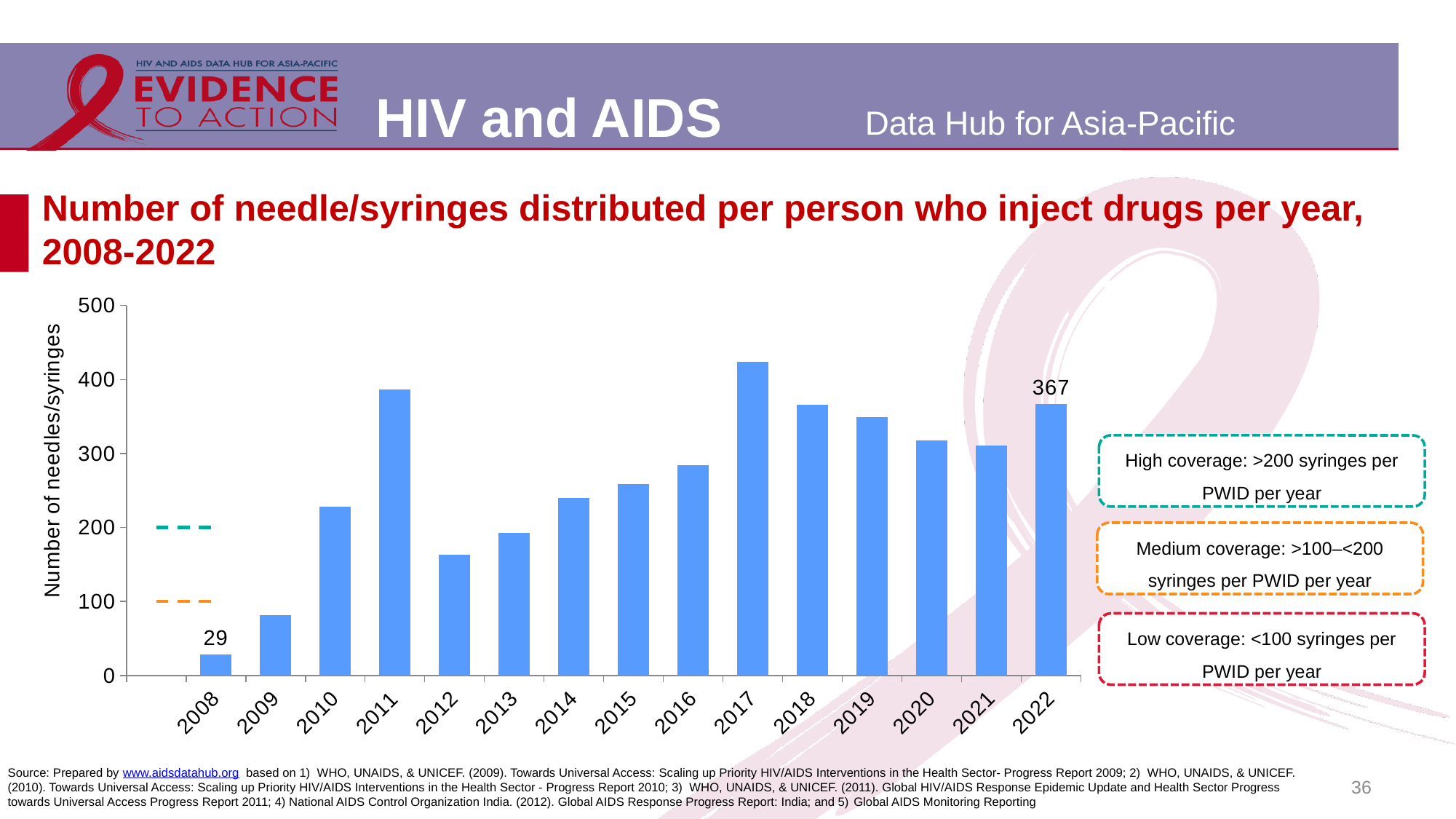
What is the difference between the values for 2022 and 2008? 338 Is the value for 2011 greater or less than 300? greater What is the value for 2022? 367 Is the value for 2009 greater or less than 100? less What is the value for 2008? 29 How many years are shown on the x axis? 15 Is the value for 2012 greater or less than 200? less Which year has a larger value, 2011 or 2012? 2011 Which year has the highest number of needles/syringes? 2017 Do the values rise or fall from 2017 to 2021? fall Which year has the lowest number of needles/syringes? 2008 What kind of chart is shown on the slide? bar chart